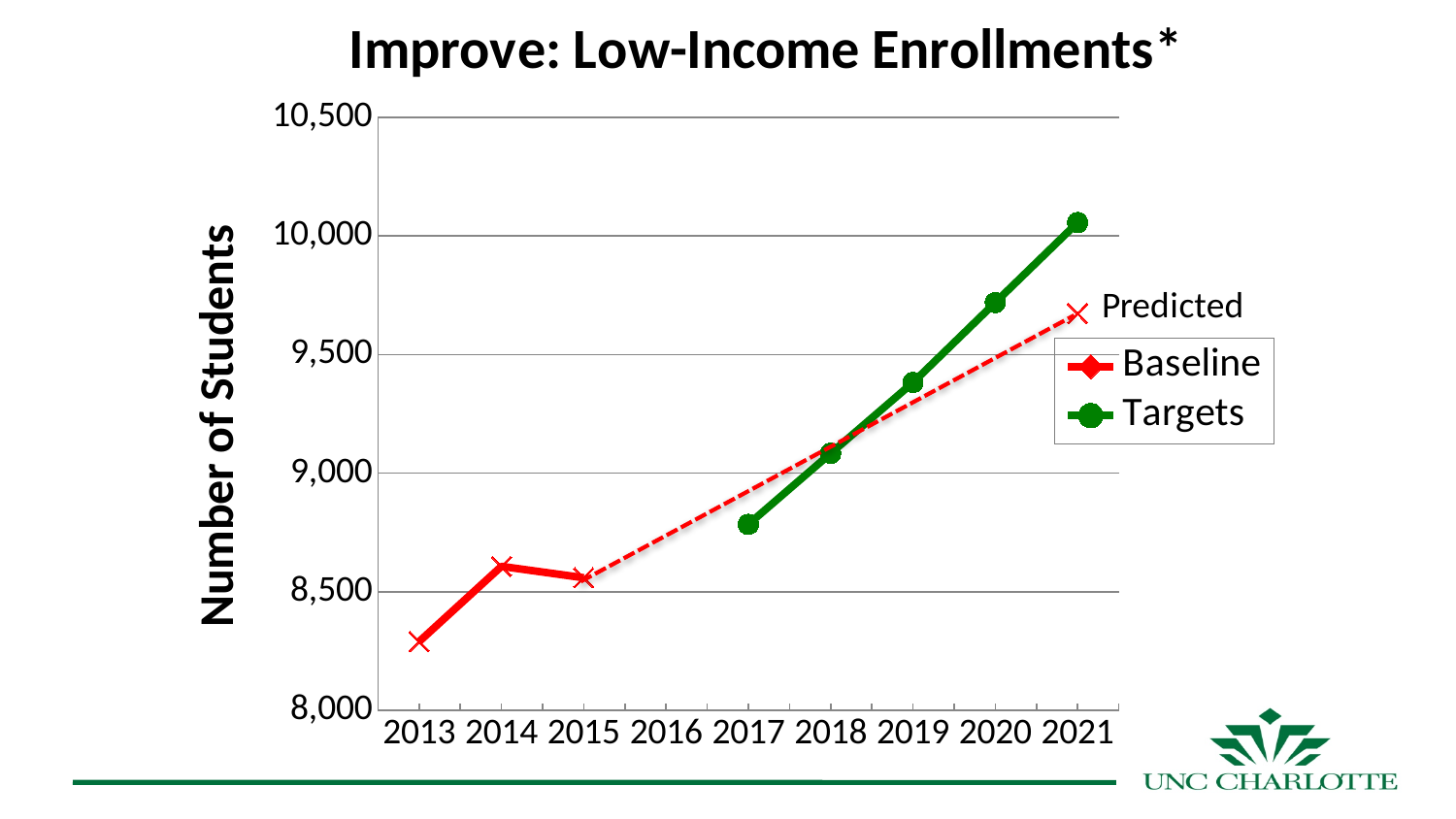
Is the Baseline value for 2013 greater or less than 8,500? less In which year is the Baseline series at its lowest value? 2013 How many data points does the Targets series have? 5 Do the Targets values rise or fall from 2017 to 2021? rise How many series does the legend list? 2 What kind of chart is shown on the slide? line chart How many years are shown on the x axis? 9 Is the Targets value for 2020 greater or less than 9,500? greater Is the Targets value for 2021 greater or less than 10,000? greater In 2021, which series has the higher value, Baseline or Targets? Targets In which year does the Targets series reach its highest value? 2021